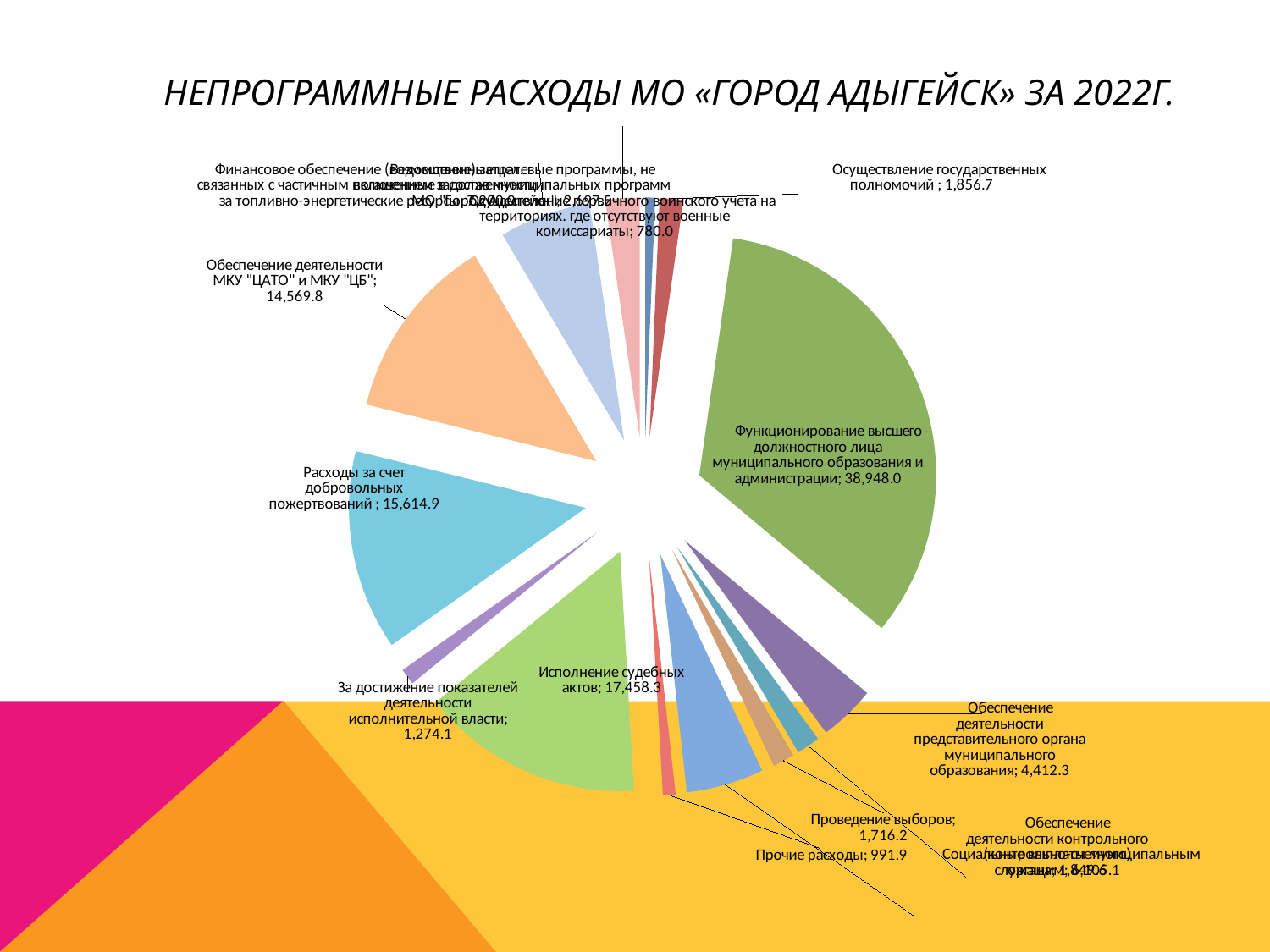
What is the value for "Обеспечение деятельности МКУ "ЦАТО" и МКУ "ЦБ""? 14,569.8 What is the value for "Расходы за счет добровольных пожертвований"? 15,614.9 What kind of chart is shown on the slide? pie chart Which is larger: "Проведение выборов" or "За достижение показателей деятельности исполнительной власти"? Проведение выборов What is the value for "Прочие расходы"? 991.9 What is the value for "Проведение выборов"? 1,716.2 What is the value for "Исполнение судебных актов"? 17,458.3 What is the value for "Функционирование высшего должностного лица муниципального образования и администрации"? 38,948.0 Which category has the largest slice of the pie? Функционирование высшего должностного лица муниципального образования и администрации What is the title of the chart? НЕПРОГРАММНЫЕ РАСХОДЫ МО «ГОРОД АДЫГЕЙСК» ЗА 2022Г. What is the difference between "Обеспечение деятельности представительного органа муниципального образования" and "Осуществление государственных полномочий"? 2,555.6 What is the difference between "Исполнение судебных актов" and "Расходы за счет добровольных пожертвований"? 1,843.4